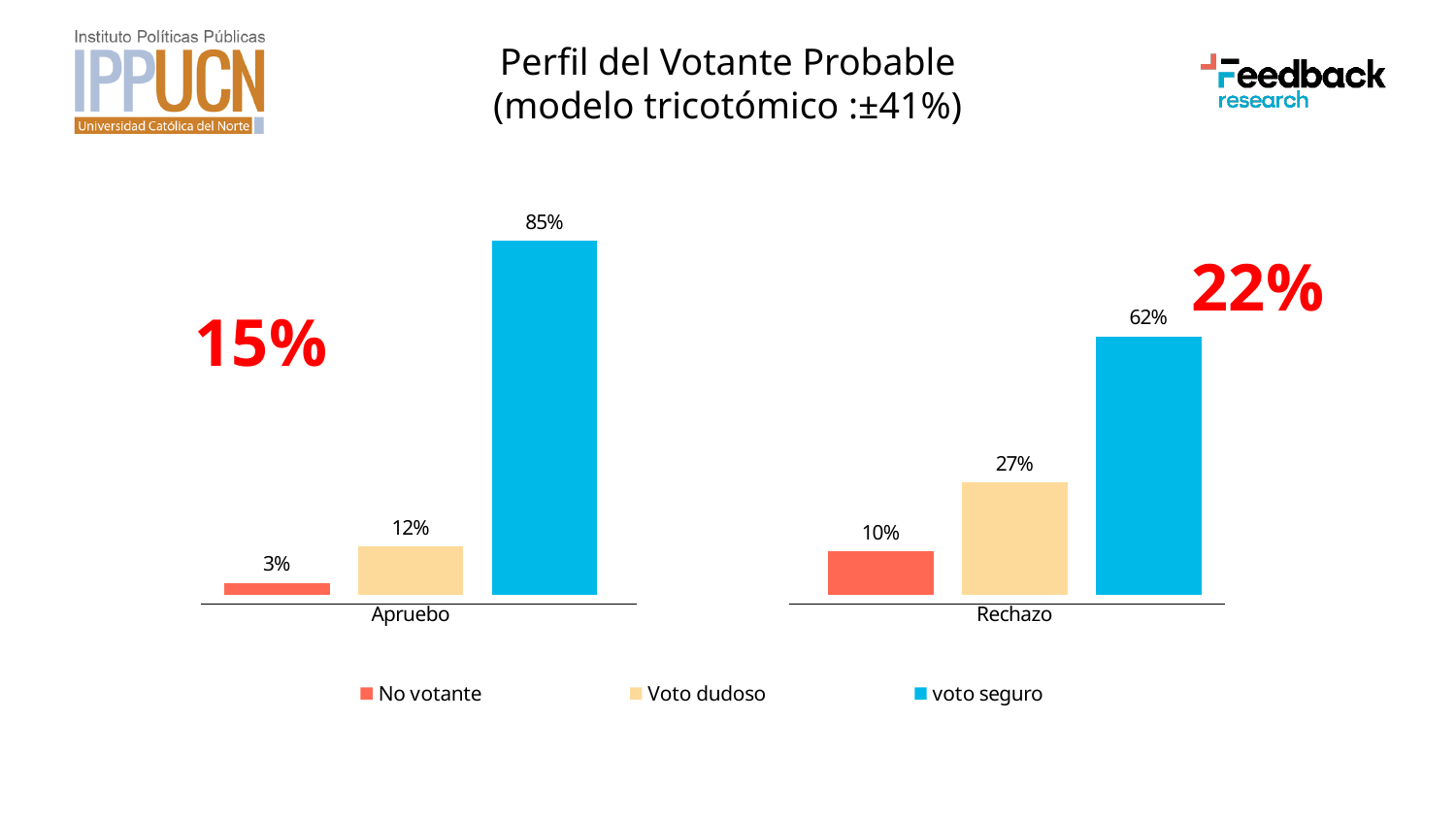
Which series has the lowest value in the Apruebo category? No votante What is the difference between the "voto seguro" values for Apruebo and Rechazo? 23% What is the value for "Voto dudoso" in the Rechazo category? 27% How many categories are shown on the x axis? 2 Which series has the highest value in the Rechazo category? voto seguro What is the title of the chart? Perfil del Votante Probable (modelo tricotómico :±41%) What is the value for "No votante" in the Rechazo category? 10% What kind of chart is shown on the slide? Bar chart How many series does the legend list? 3 What is the value for "voto seguro" in the Apruebo category? 85% What is the value for "Voto dudoso" in the Apruebo category? 12% Which is larger: "Voto dudoso" for Apruebo or "Voto dudoso" for Rechazo? Rechazo